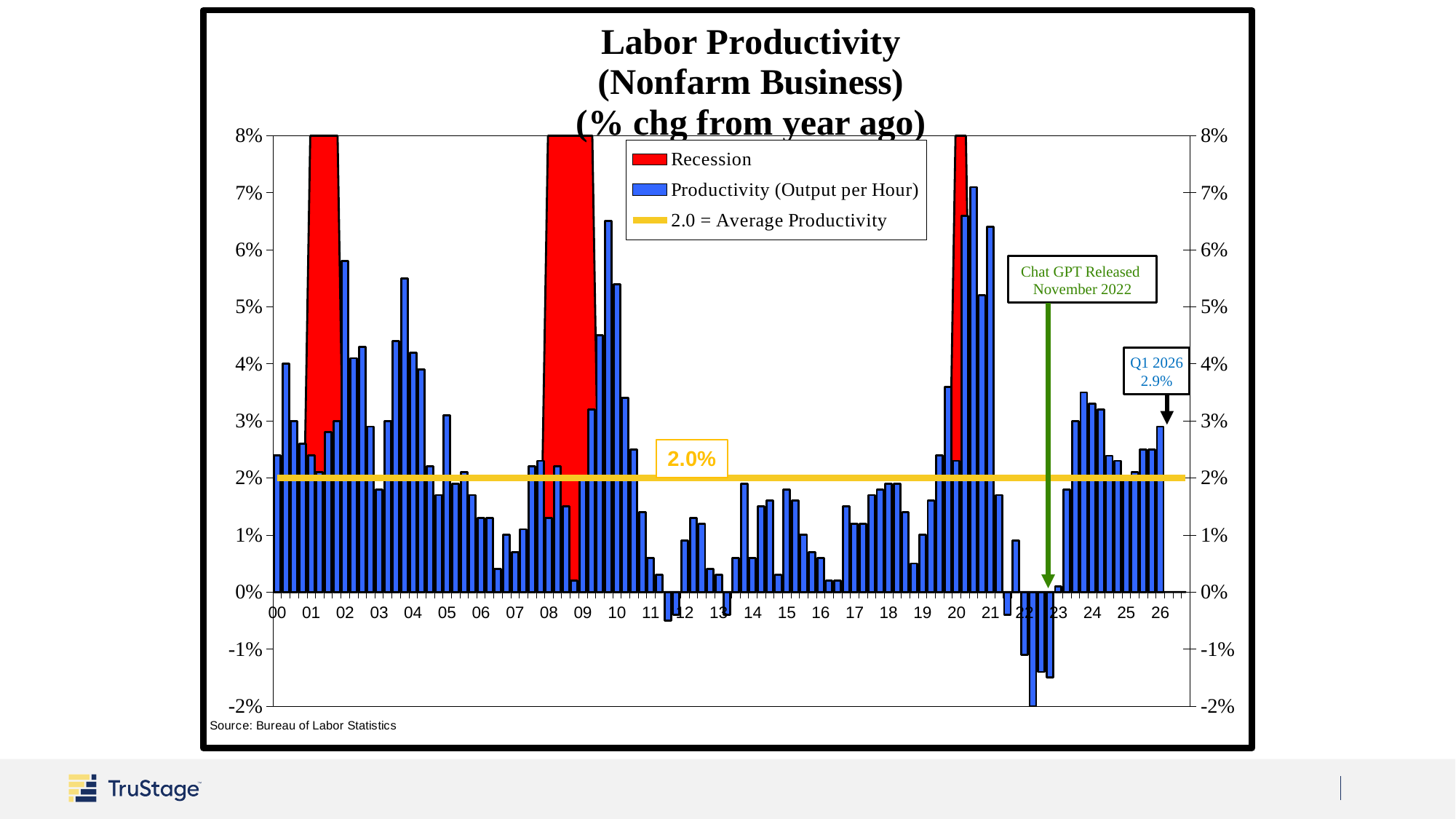
What does the red shading on the chart represent according to the legend? Recession Between 2022 and 2024, do the productivity values rise or fall? Rise What kind of chart is used to show productivity on this slide? Bar chart Is the lowest productivity value around 2022 greater or less than -1%? Less How many entries does the legend list? 3 What is the source of the data cited on the chart? Bureau of Labor Statistics Is the Q1 2026 productivity value greater or less than the 2.0% average line? Greater Is the highest productivity bar around 2020 greater or less than 6%? Greater What is the labor productivity value shown for Q1 2026? 2.9% What value does the yellow horizontal line representing average productivity mark? 2.0% Are the productivity values around 2016 greater or less than 2%? Less How many recession periods are shaded in red on the chart? 3